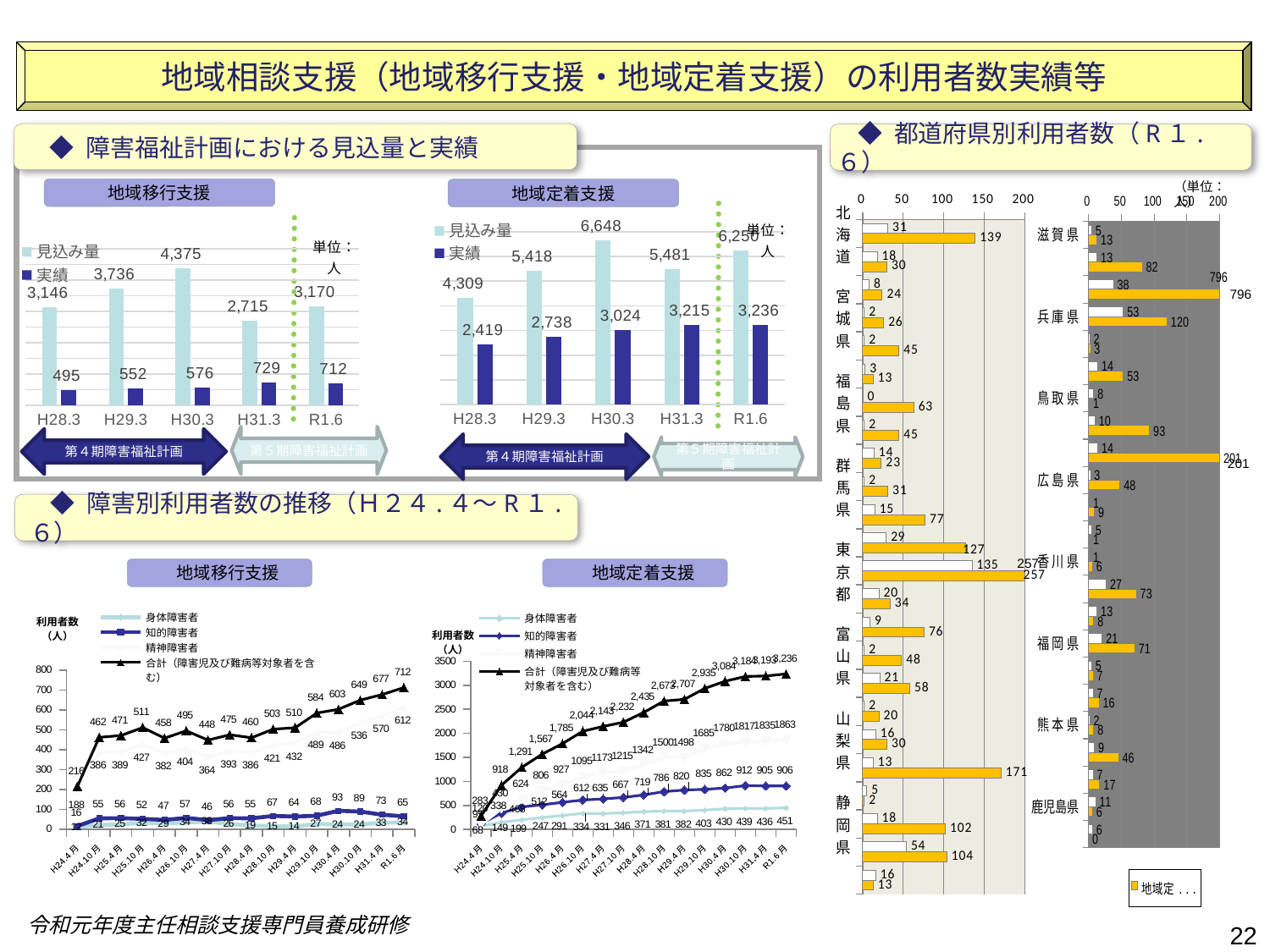
In the 地域移行支援 bar chart under 障害福祉計画における見込量と実績, which is larger, the 実績 for H31.3 or for R1.6? H31.3 In the 地域定着支援 line chart under 障害別利用者数の推移, does the 合計 series rise or fall from H24.4月 to R1.6月? rise In the 地域移行支援 bar chart under 障害福祉計画における見込量と実績, what is the difference between 見込量 and 実績 for H28.3? 2,651 In the 地域移行支援 line chart under 障害別利用者数の推移, how many series does the legend list? 4 In the 地域定着支援 bar chart under 障害福祉計画における見込量と実績, what is the difference between 見込量 and 実績 for H29.3? 2,680 In the 地域移行支援 bar chart under 障害福祉計画における見込量と実績, what is the 実績 value for H31.3? 729 In the 地域定着支援 line chart under 障害別利用者数の推移, what is the 合計 value at R1.6月? 3,236 In the 地域移行支援 bar chart under 障害福祉計画における見込量と実績, what is the 見込量 value for H30.3? 4,375 In the 地域定着支援 bar chart under 障害福祉計画における見込量と実績, which period has the highest 見込量? H30.3 In the 地域移行支援 bar chart under 障害福祉計画における見込量と実績, how many periods are shown on the x axis? 5 In the 地域定着支援 bar chart under 障害福祉計画における見込量と実績, what is the 実績 value for R1.6? 3,236 What kind of chart is the 都道府県別利用者数 chart on the right of the slide? bar chart